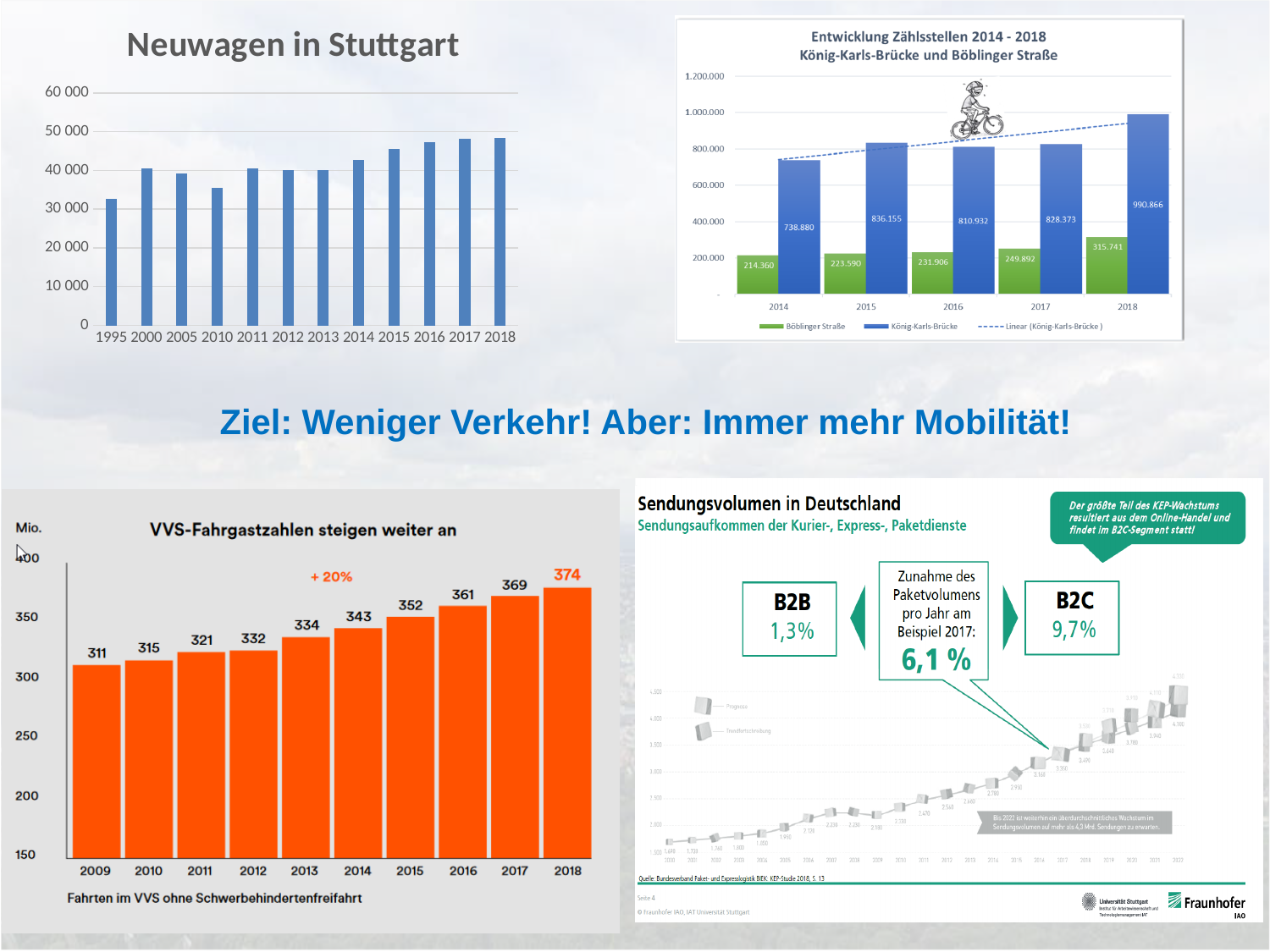
In the 'VVS-Fahrgastzahlen steigen weiter an' chart, what is the value for 2013? 334 In the 'Entwicklung Zählsstellen 2014 - 2018' chart, what is the value for König-Karls-Brücke in 2018? 990.866 In the 'Entwicklung Zählsstellen 2014 - 2018' chart, what is the difference between König-Karls-Brücke and Böblinger Straße in 2018? 675.125 In the 'Entwicklung Zählsstellen 2014 - 2018' chart, which year has the highest value for König-Karls-Brücke? 2018 In the 'Entwicklung Zählsstellen 2014 - 2018' chart, how many entries does the legend list? 3 In the 'Entwicklung Zählsstellen 2014 - 2018' chart, what is the value for Böblinger Straße in 2014? 214.360 In the 'VVS-Fahrgastzahlen steigen weiter an' chart, what is the difference between the values for 2018 and 2009? 63 In the 'Neuwagen in Stuttgart' chart, is the value for 2018 greater or less than 40 000? greater In the 'Neuwagen in Stuttgart' chart, which year has the lowest value? 1995 In the 'Neuwagen in Stuttgart' chart, how many years are shown on the x axis? 12 In the 'Neuwagen in Stuttgart' chart, is the value for 1995 greater or less than 40 000? less In the 'VVS-Fahrgastzahlen steigen weiter an' chart, do the values rise or fall from 2009 to 2018? rise